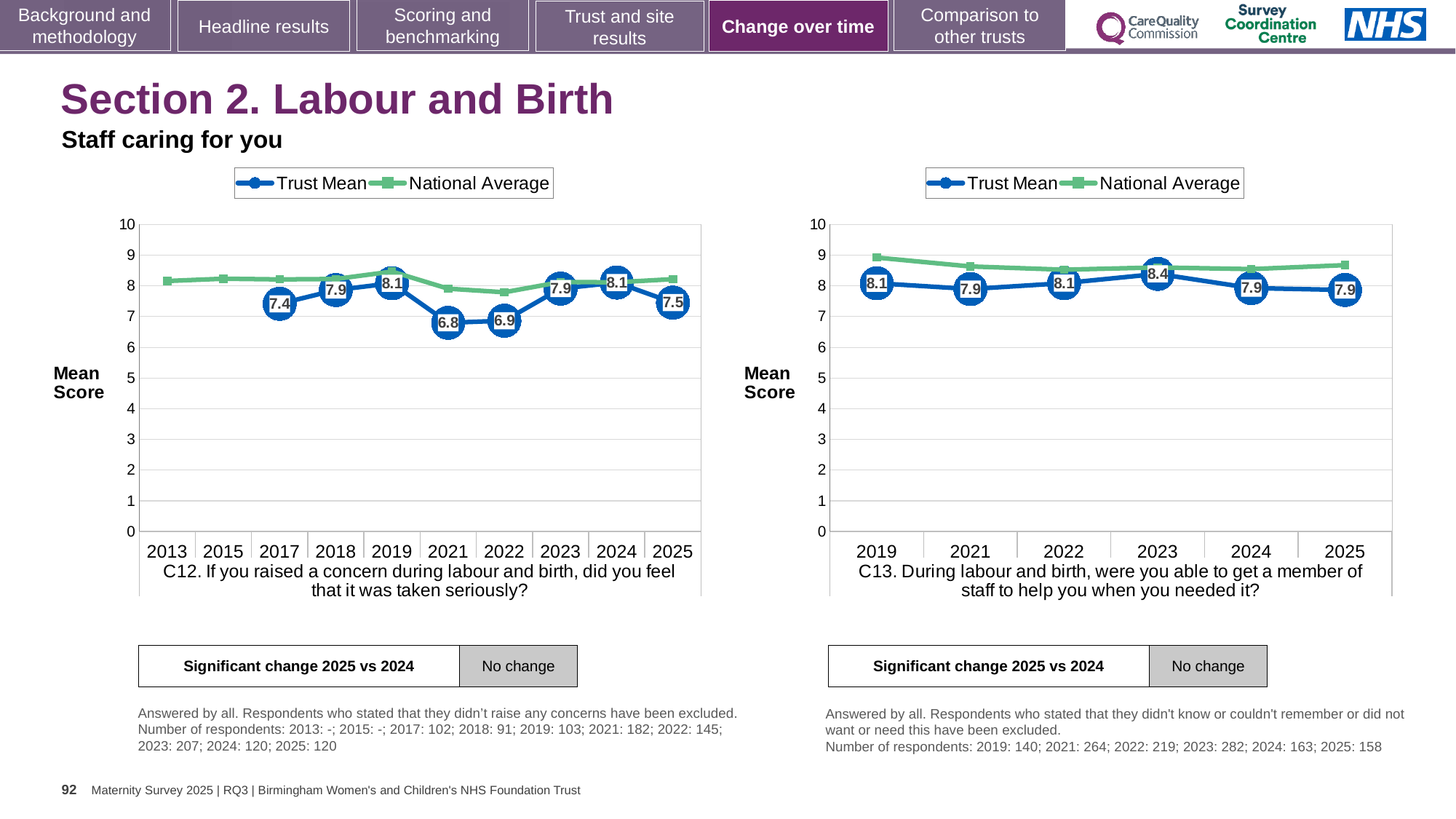
In the C12 chart (left), how many years are shown on the x axis? 10 What kind of chart is the C13 chart (right)? Line chart In the C13 chart (right), what is the Trust Mean score for 2023? 8.4 In the C13 chart (right), how many series does the legend list? 2 In the C13 chart (right), does the Trust Mean rise or fall from 2023 to 2024? fall In the C12 chart (left), what is the difference between the Trust Mean scores for 2024 and 2025? 0.6 In the C12 chart (left), is the National Average for 2021 greater or less than 7? greater In the C12 chart (left), what is the Trust Mean score for 2025? 7.5 In the C12 chart (left), what is the Trust Mean score for 2021? 6.8 In the C12 chart (left), which year has the lowest Trust Mean score? 2021 In the C13 chart (right), which year has the highest Trust Mean score? 2023 In the C13 chart (right), is the Trust Mean for 2021 larger or smaller than the Trust Mean for 2022? smaller